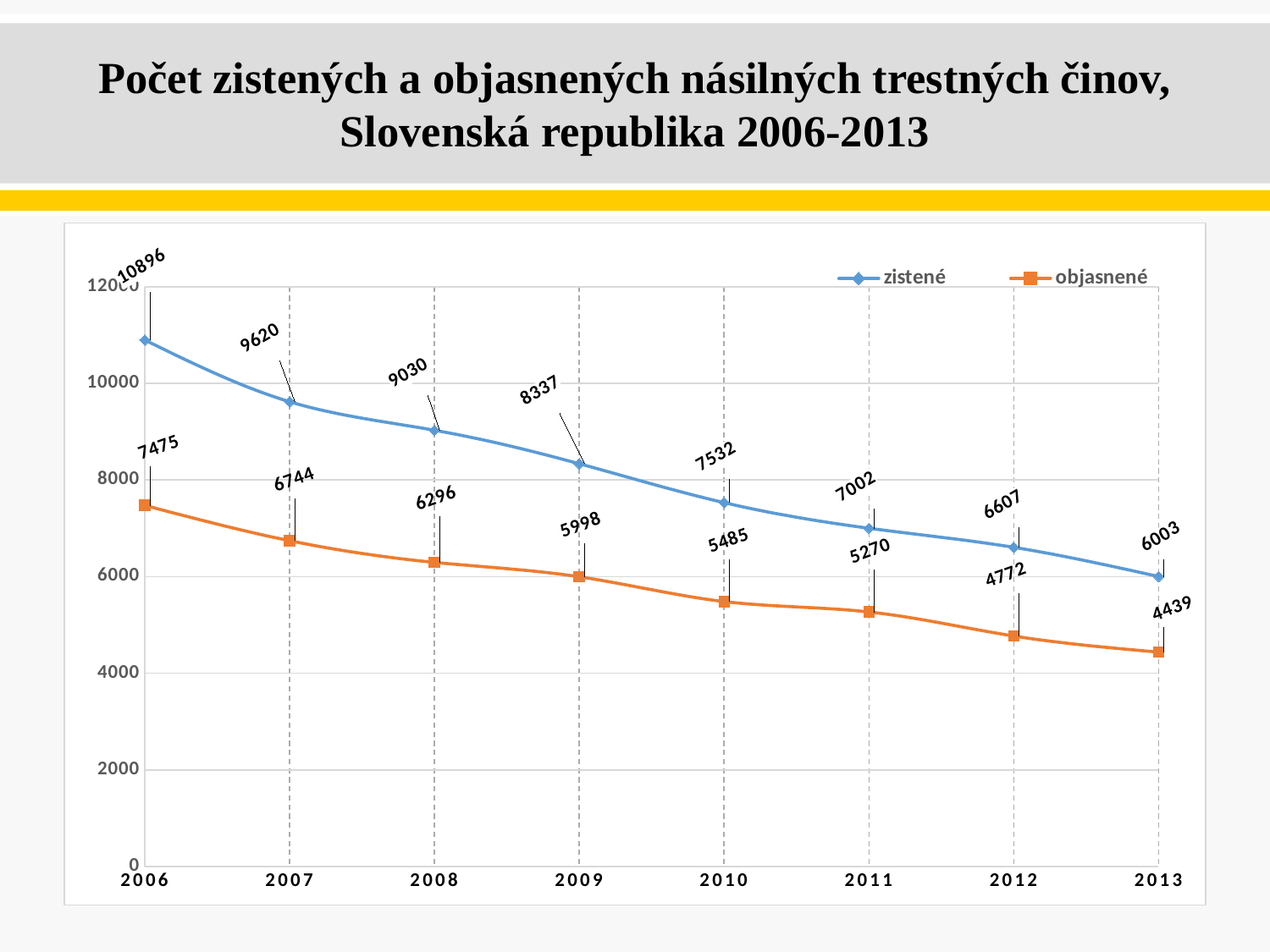
What is the difference between zistené and objasnené in 2008? 2734 What kind of chart is shown? line chart In which year is zistené highest? 2006 Which is larger in 2011: zistené or objasnené? zistené What is the value of zistené in 2006? 10896 What is the value of objasnené in 2009? 5998 What is the value of zistené in 2010? 7532 In which year is objasnené lowest? 2013 How many years are shown on the x axis? 8 What is the value of objasnené in 2013? 4439 How many series does the legend list? 2 Do the zistené values rise or fall from 2006 to 2013? fall